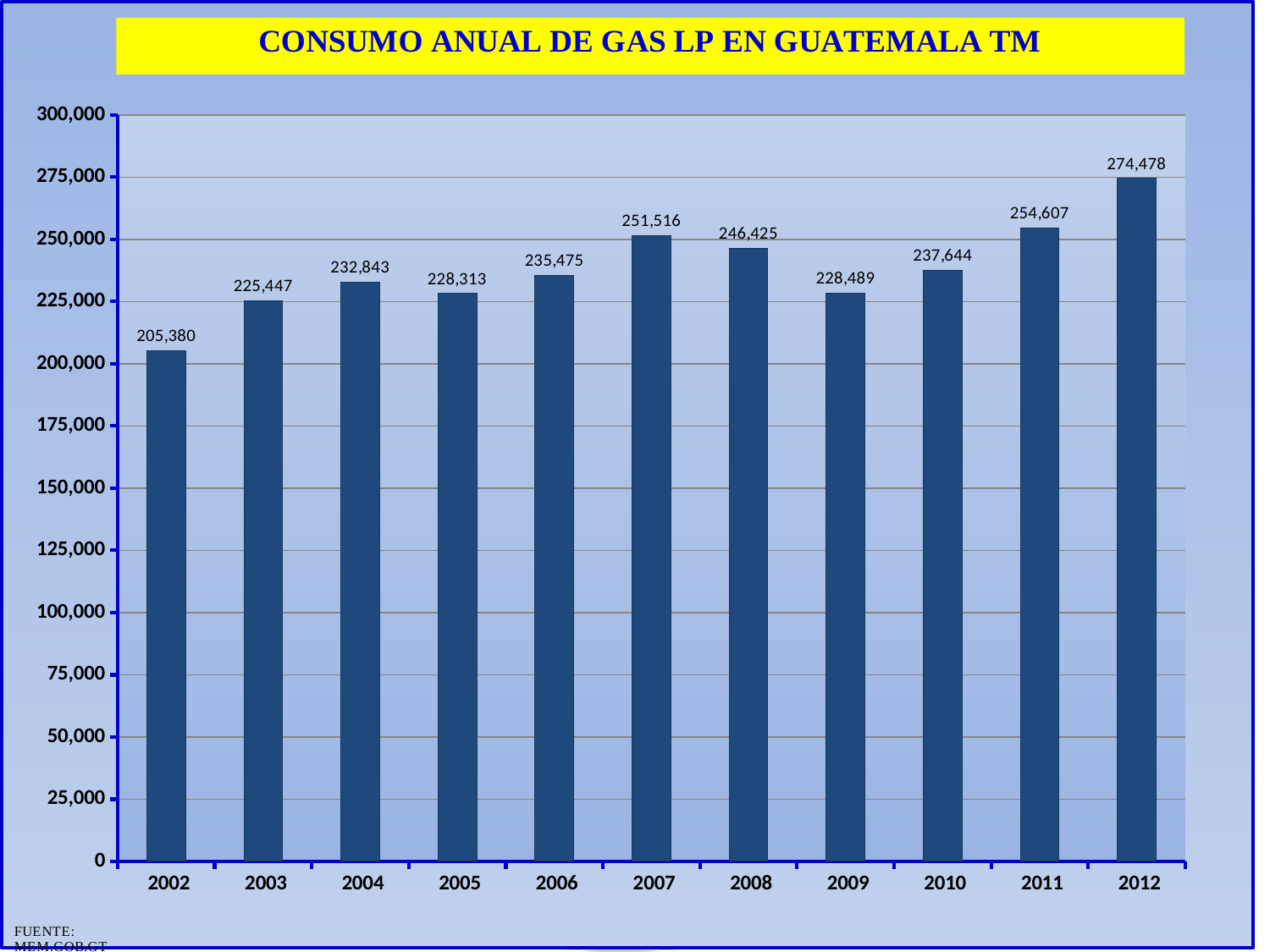
What was the consumption in 2002? 205,380 What type of chart is shown on the slide? bar chart How much higher is the 2011 value than the 2010 value? 16,963 What was the annual LP gas consumption in Guatemala in 2012? 274,478 How many years are shown on the chart? 11 What value is shown for 2007? 251,516 Which year has the highest consumption? 2012 Which year has the lowest consumption? 2002 Is the value for 2009 greater or less than 250,000? less Which year had higher consumption, 2007 or 2008? 2007 What is the title of the chart? CONSUMO ANUAL DE GAS LP EN GUATEMALA TM What is the difference between the 2012 and 2002 values? 69,098